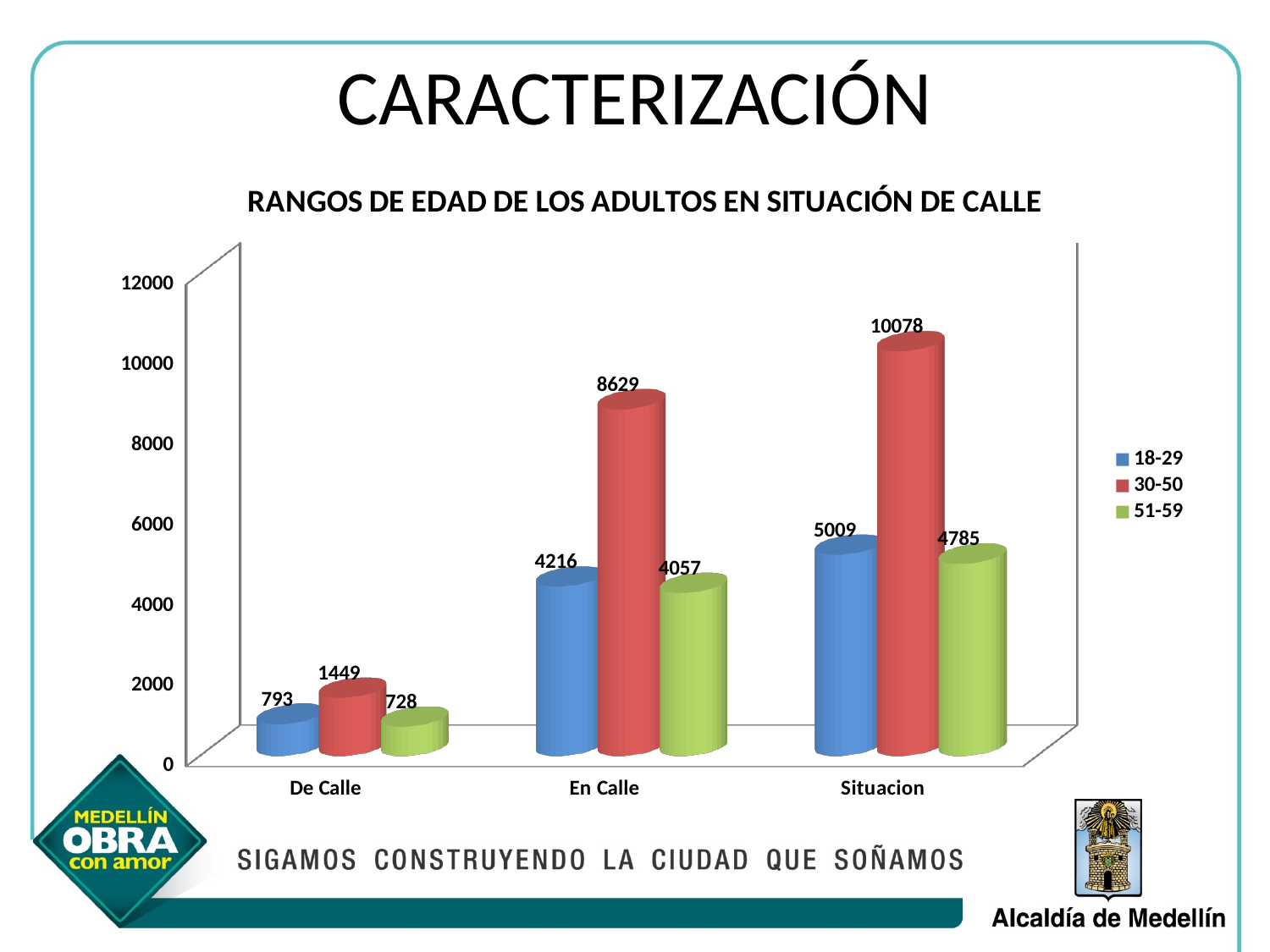
Which category has the lowest value for the 18-29 series? De Calle What is the difference between the 30-50 value and the 18-29 value in the En Calle category? 4413 How many categories are shown on the x axis? 3 Which is larger: the 51-59 value for Situacion or the 18-29 value for En Calle? 51-59 value for Situacion How many series does the legend list? 3 Which series has the highest value in the Situacion category? 30-50 What is the title of the chart? RANGOS DE EDAD DE LOS ADULTOS EN SITUACIÓN DE CALLE Do the values for the 30-50 series rise or fall from De Calle to Situacion? Rise What is the value for the 30-50 series in the En Calle category? 8629 What is the value for the 51-59 series in the De Calle category? 728 What kind of chart is shown on the slide? Bar chart What is the value for the 18-29 series in the Situacion category? 5009